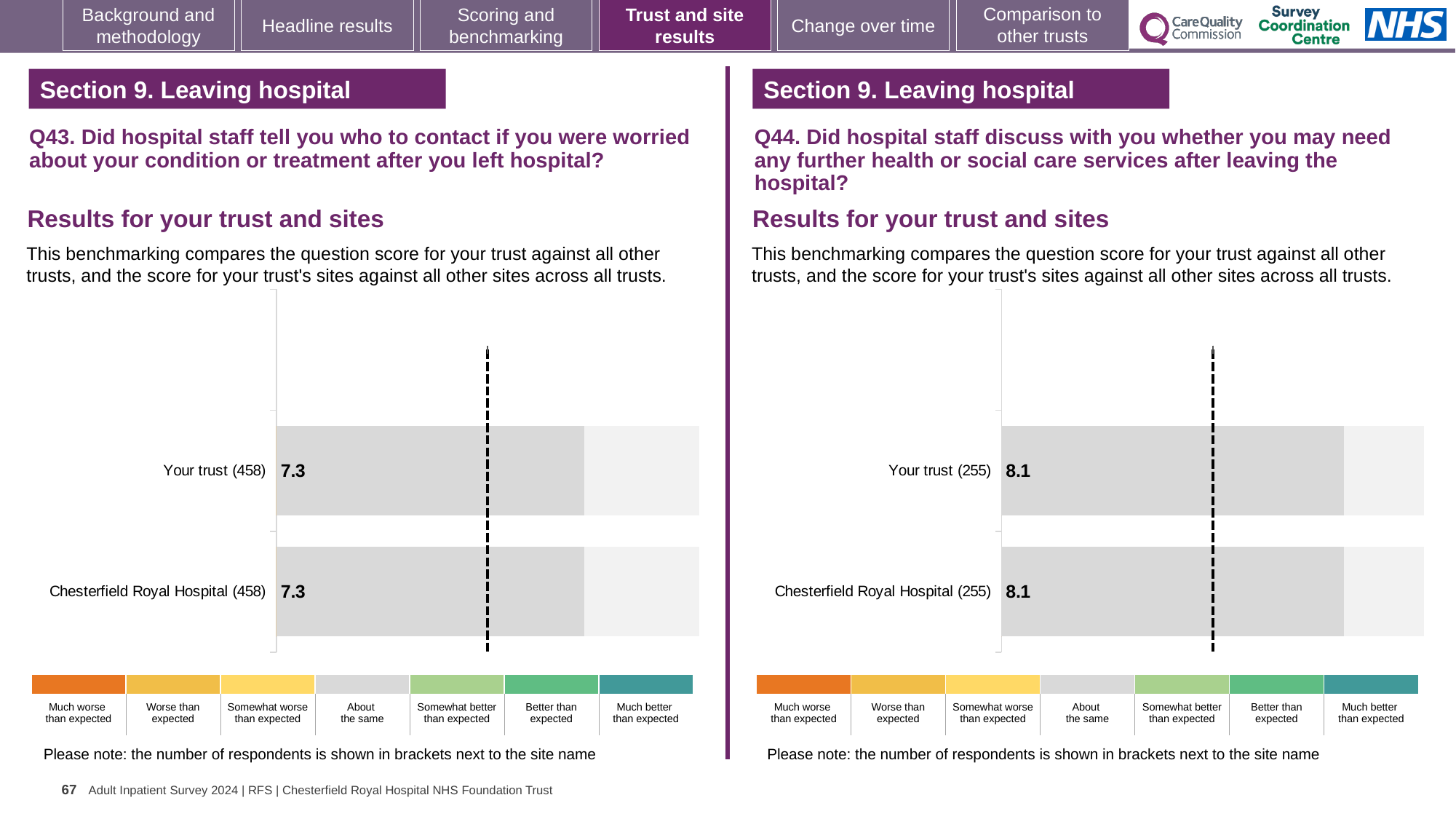
On the Q43 chart (left), what is the score for Chesterfield Royal Hospital? 7.3 On the Q43 chart (left), what is the score for Your trust? 7.3 What kind of chart is used on the Q44 chart (right)? Bar chart On the Q44 chart (right), what is the score for Chesterfield Royal Hospital? 8.1 On the Q44 chart (right), what is the score for Your trust? 8.1 On the Q44 chart (right), how many respondents are shown in brackets for Chesterfield Royal Hospital? 255 On the Q44 chart (right), how many bars are plotted? 2 On the Q43 chart (left), how many categories does the colour legend below the chart list? 7 On the Q44 chart (right), what is the label of the leftmost (orange) legend category? Much worse than expected On the Q43 chart (left), how many respondents are shown in brackets for Your trust? 458 On the Q43 chart (left), how many bars are plotted? 2 On the Q43 chart (left), what is the difference between the score for Your trust and the score for Chesterfield Royal Hospital? 0